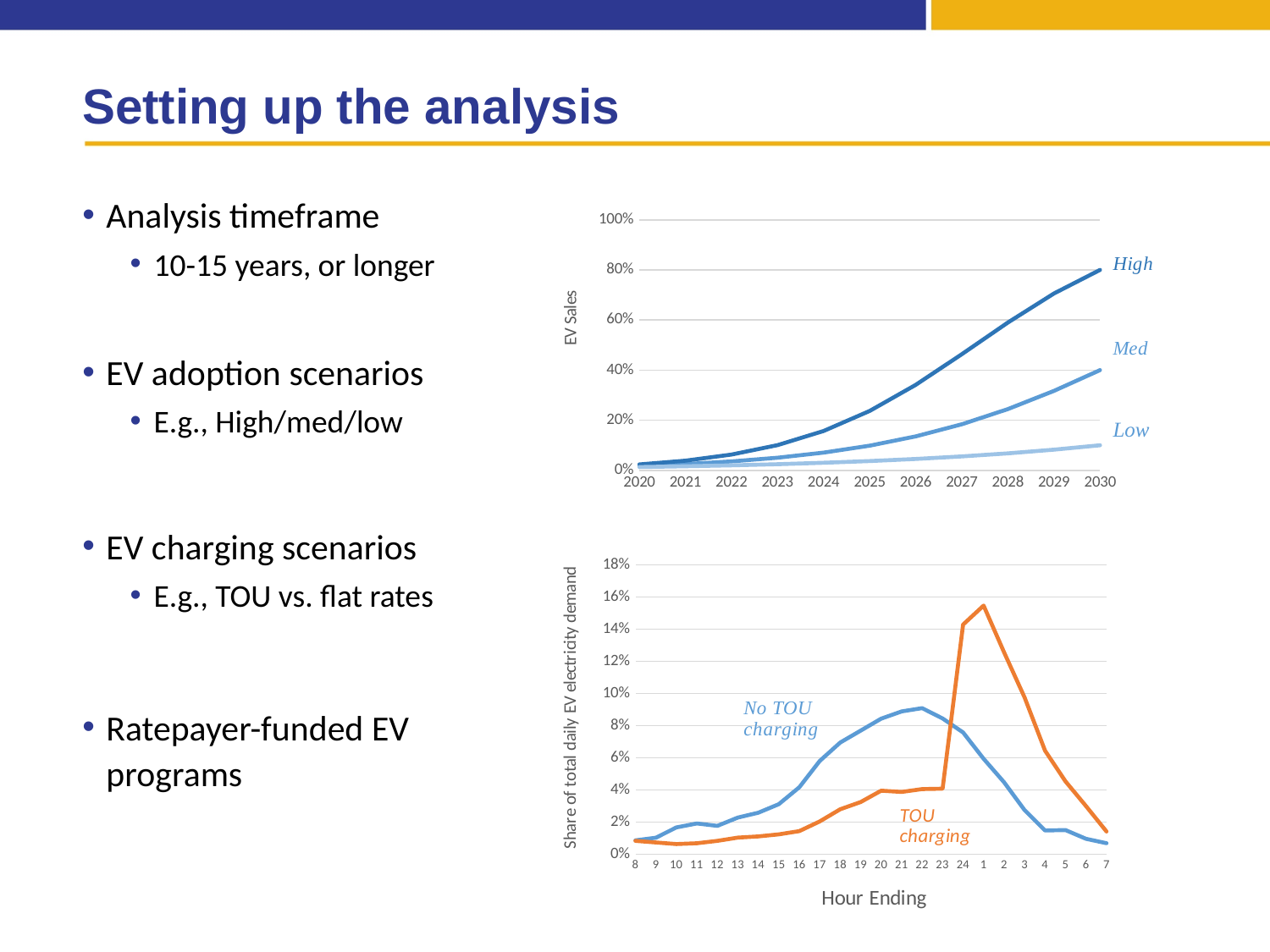
In the top chart (EV Sales), which scenario has the lowest value in 2030? Low In the top chart (EV Sales), is the Low scenario value in 2030 greater or less than 20%? less In the bottom chart, which series reaches the higher peak, No TOU charging or TOU charging? TOU charging In the top chart (EV Sales), how many years are shown on the x axis? 11 In the top chart (EV Sales), does the High scenario rise or fall from 2020 to 2030? rise What kind of chart is the top chart on the slide (EV Sales)? line chart What is the x-axis title of the bottom chart? Hour Ending In the bottom chart, is the TOU charging value at hour ending 1 greater or less than 14%? greater In the top chart (EV Sales), is the High scenario value in 2030 greater or less than 60%? greater What kind of chart is the bottom chart on the slide (Share of total daily EV electricity demand)? line chart In the top chart (EV Sales), which scenario has the highest value in 2030? High In the top chart (EV Sales), how many scenario lines are plotted? 3